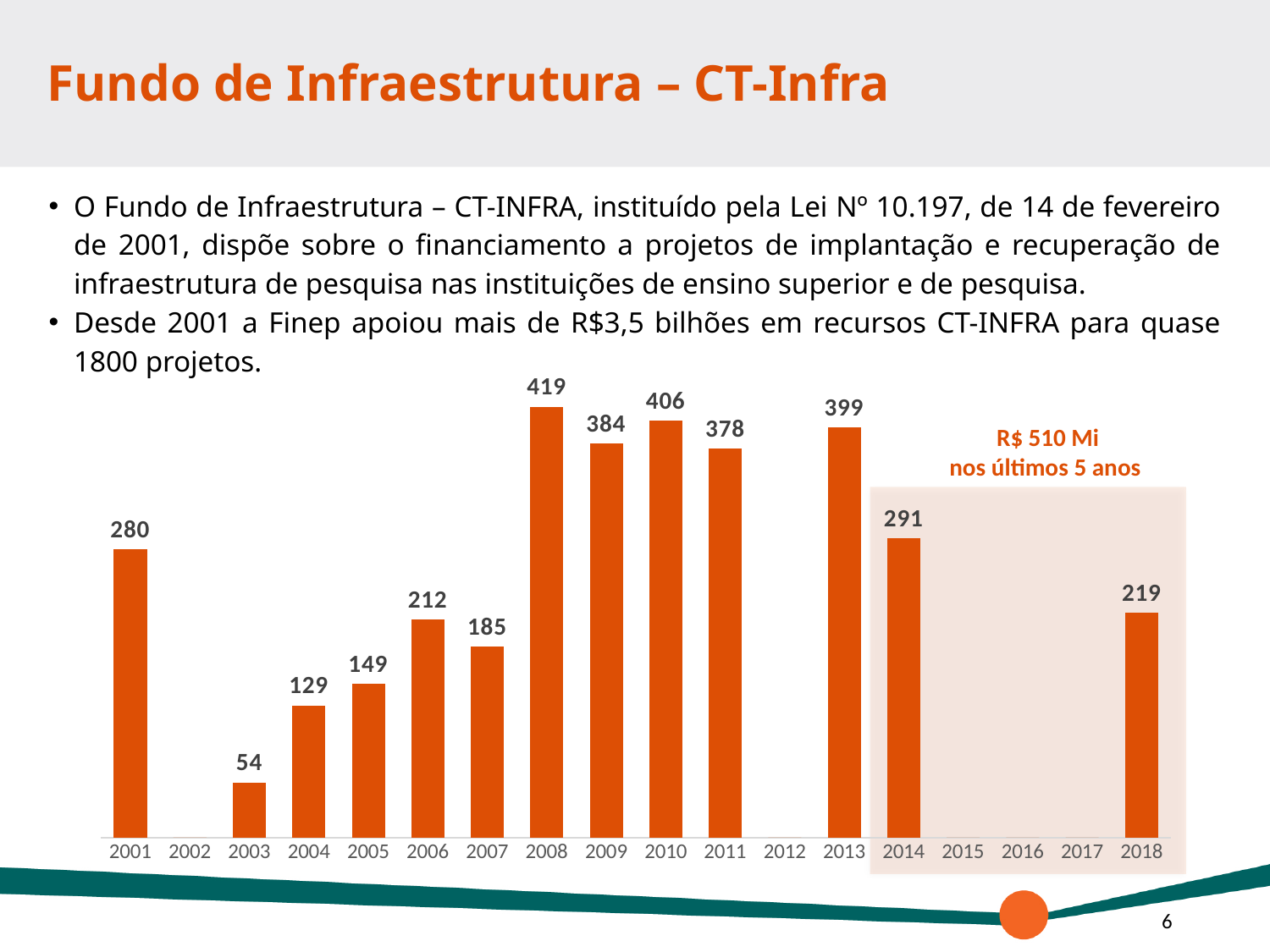
What is the value shown for 2014? 291 Which year has the lowest value among the bars shown? 2003 Which is larger, the value for 2006 or the value for 2007? 2006 What is the difference between the values for 2010 and 2011? 28 What is the value shown for 2018? 219 What is the value shown for 2008? 419 What does the text label inside the shaded area of the chart say? R$ 510 Mi nos últimos 5 anos Which year has the highest value in the chart? 2008 Do the values rise or fall from 2003 to 2006? Rise How many years have a bar plotted in the chart? 13 What is the value shown for 2003? 54 What kind of chart is shown on the slide? Bar chart